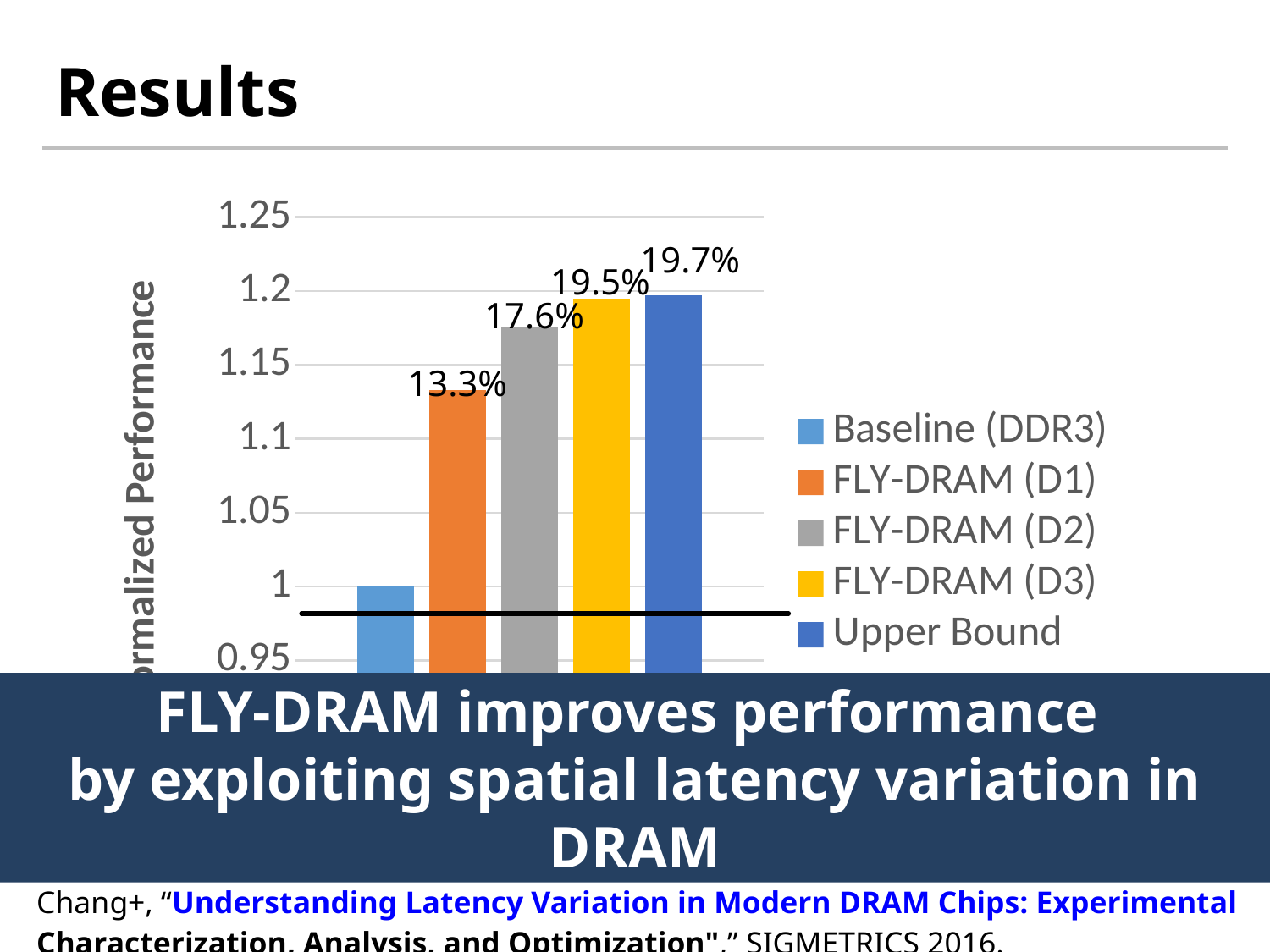
What is the data label shown above the Upper Bound bar? 19.7% How many series does the legend list? 5 What kind of chart is shown on the slide? bar chart Which series has the highest normalized performance? Upper Bound What normalized performance value does the Baseline (DDR3) bar reach? 1 What is the data label shown above the FLY-DRAM (D2) bar? 17.6% What is the data label shown above the FLY-DRAM (D3) bar? 19.5% Which series has the lowest normalized performance? Baseline (DDR3) Which is larger, the normalized performance for FLY-DRAM (D2) or FLY-DRAM (D1)? FLY-DRAM (D2) Is the normalized performance for FLY-DRAM (D1) greater or less than 1.1? greater Do the bar values rise or fall from left to right across the chart? rise What is the data label shown above the FLY-DRAM (D1) bar? 13.3%